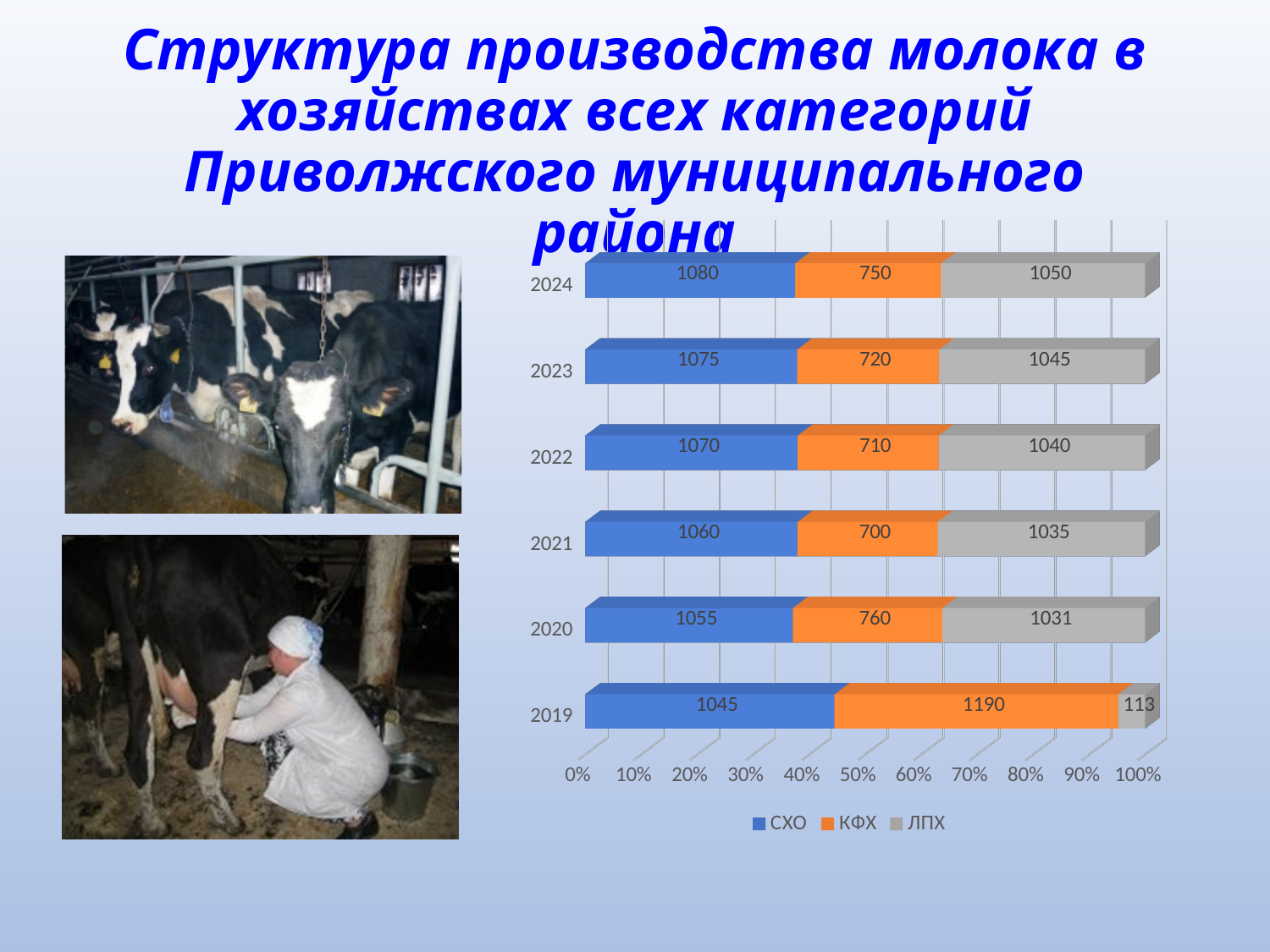
What is the difference between the СХО value in 2024 and in 2019? 35 In which year is the КФХ value the highest? 2019 What is the value for СХО in 2024? 1080 What is the value for КФХ in 2019? 1190 How many years are shown on the chart? 6 What is the total of the three values in the 2024 bar? 2880 What is the value for ЛПХ in 2021? 1035 What kind of chart is shown on the slide? Stacked bar chart As the years go from 2019 to 2024, do the СХО values rise or fall? Rise Which year has the larger КФХ value, 2020 or 2021? 2020 How many series does the legend list? 3 In which year is the ЛПХ value the lowest? 2019